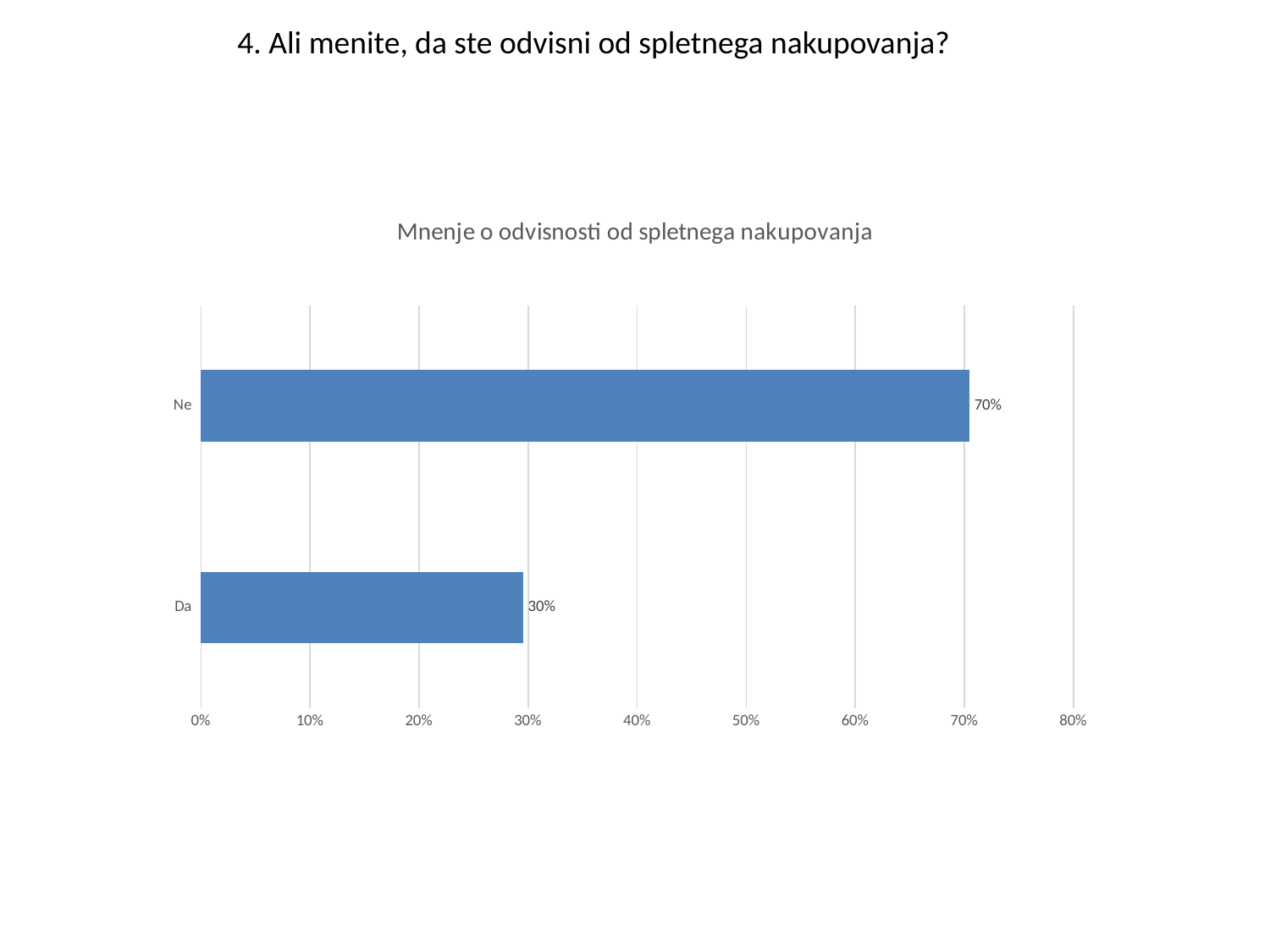
What is the value for Da? 30% What is the value for Ne? 70% How many categories are shown in the chart? 2 What is the title of the chart? Mnenje o odvisnosti od spletnega nakupovanja Is the value for Da greater or less than 40%? less Which category has the highest value? Ne What kind of chart is shown on the slide? bar chart What is the difference between the values for Ne and Da? 40% Which category has the lowest value? Da Is the value for Ne greater or less than 60%? greater Which is larger, the value for Ne or the value for Da? Ne What is the highest value shown on the x axis? 80%